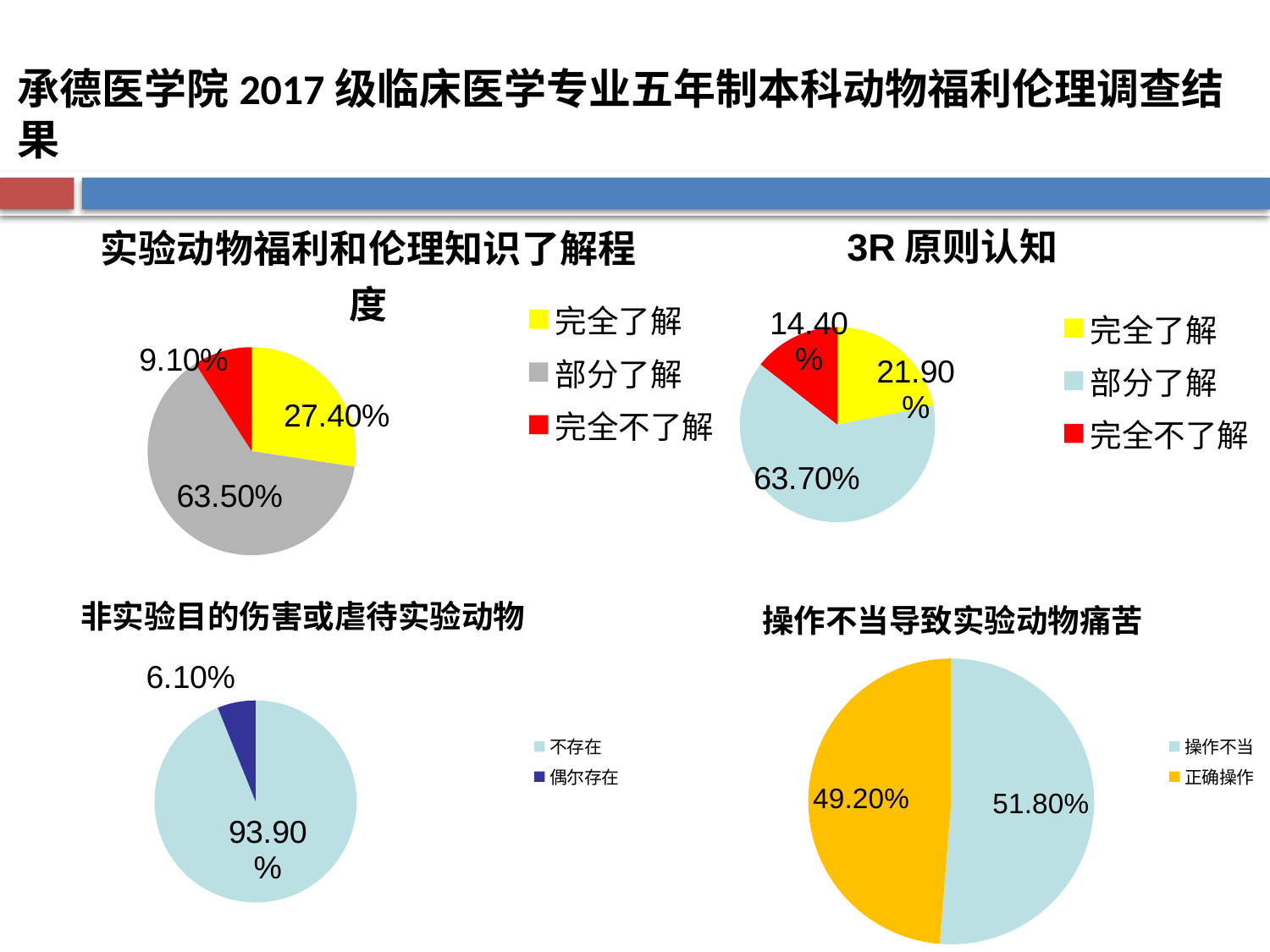
How many charts are shown on the slide? 4 In the chart titled 3R原则认知, which category has the largest share? 部分了解 In the chart titled 实验动物福利和伦理知识了解程度, what is the difference between the shares for 完全了解 and 完全不了解? 18.30% How many categories does the chart titled 非实验目的伤害或虐待实验动物 show? 2 In the chart titled 非实验目的伤害或虐待实验动物, what is the share for 偶尔存在? 6.10% In the chart titled 实验动物福利和伦理知识了解程度, which category has the smallest share? 完全不了解 In the chart titled 操作不当导致实验动物痛苦, what is the share for 正确操作? 49.20% In the chart titled 3R原则认知, what is the share for 完全不了解? 14.40% In the chart titled 实验动物福利和伦理知识了解程度, what is the share for 部分了解? 63.50% In the chart titled 操作不当导致实验动物痛苦, what is the difference between the shares for 操作不当 and 正确操作? 2.60% What kind of chart is the chart titled 操作不当导致实验动物痛苦? Pie chart In the chart titled 3R原则认知, which is larger, the share for 完全了解 or the share for 完全不了解? 完全了解